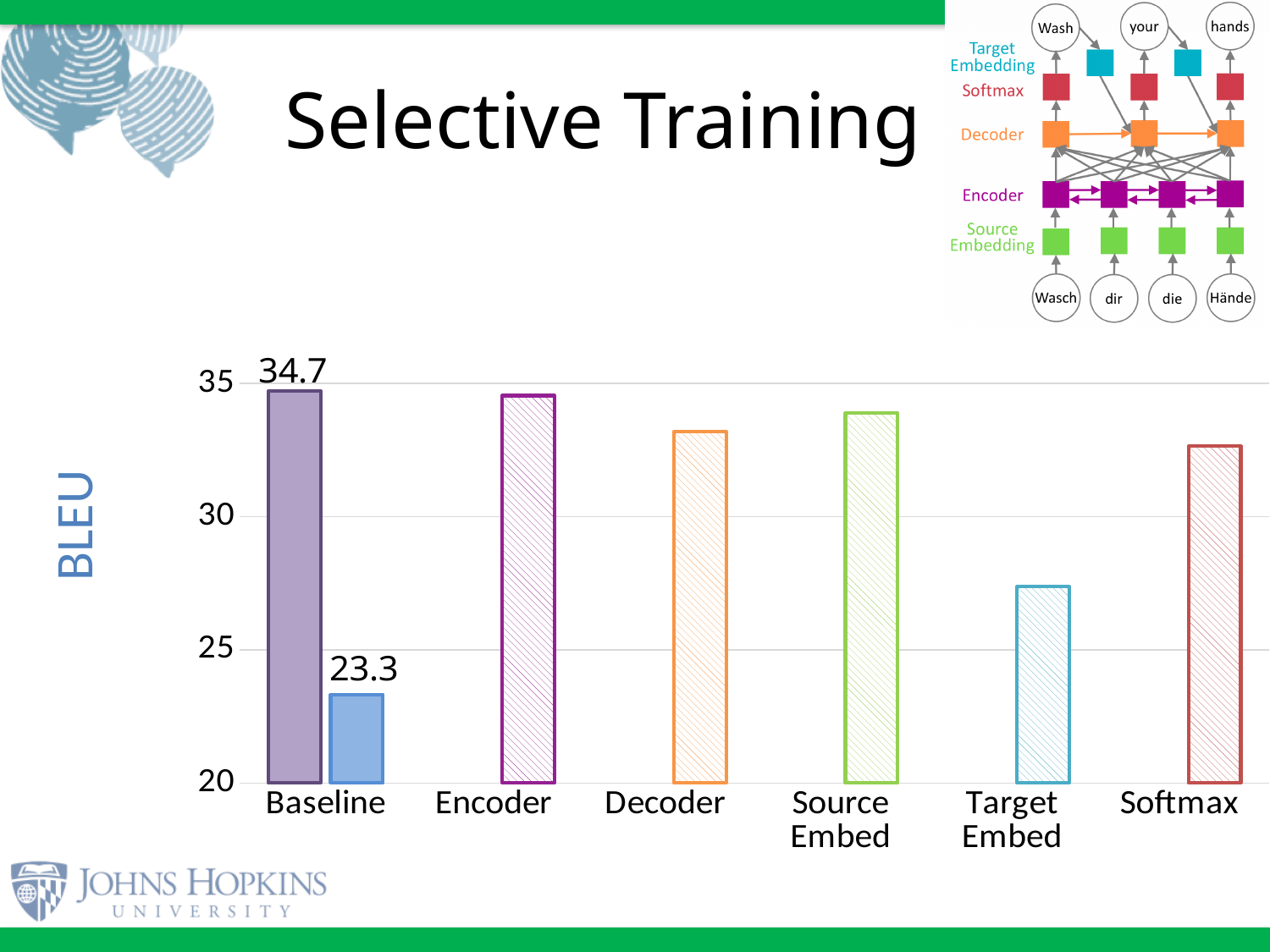
What is the value of the shorter Baseline bar? 23.3 What is the label on the y axis of the chart? BLEU Is the value for Encoder greater or less than 30? greater Is the value for Target Embed greater or less than 30? less What kind of chart is shown on the slide? bar chart Is the value for Target Embed greater or less than 25? greater Which is larger, the value for Decoder or the value for Target Embed? Decoder How many categories are shown on the x axis? 6 What is the difference between the two Baseline bars (34.7 and 23.3)? 11.4 Which of the hatched bars (Encoder, Decoder, Source Embed, Target Embed, Softmax) is the lowest? Target Embed What is the value of the taller Baseline bar? 34.7